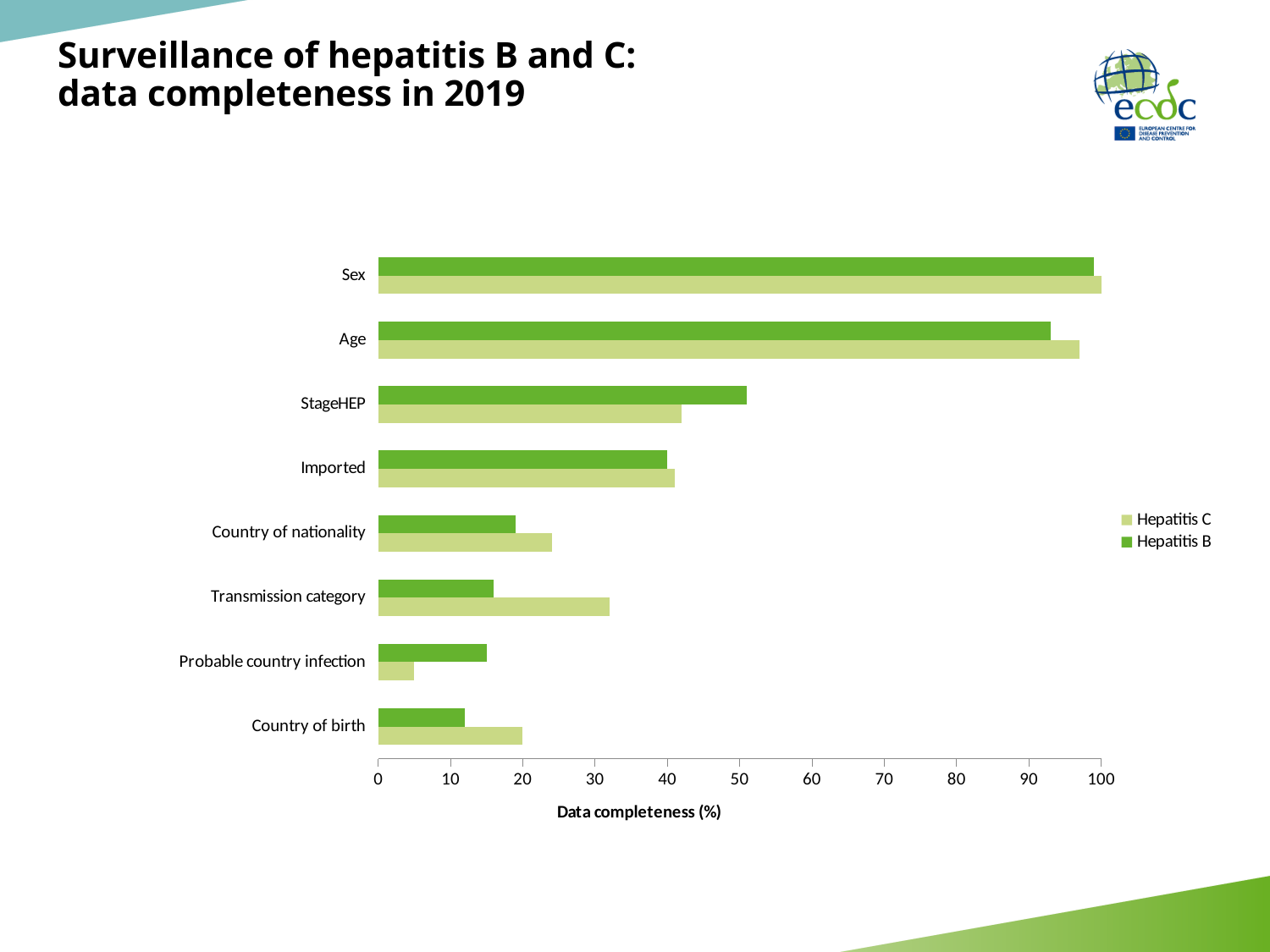
For Transmission category, which series has the higher data completeness, Hepatitis B or Hepatitis C? Hepatitis C What is the title of the x axis of the chart? Data completeness (%) For Probable country infection, which series has the higher data completeness, Hepatitis B or Hepatitis C? Hepatitis B Which variable has the lowest data completeness for Hepatitis C? Probable country infection Is the Hepatitis C data completeness for StageHEP greater or less than 50? less Is the Hepatitis C data completeness for Probable country infection greater or less than 10? less Which variable has the highest data completeness for Hepatitis C? Sex Is the Hepatitis B data completeness for Age greater or less than 90? greater How many variables (categories) are shown on the y axis of the chart? 8 How many series does the legend list? 2 Which variable has the lowest data completeness for Hepatitis B? Country of birth What kind of chart is shown on the slide? Bar chart